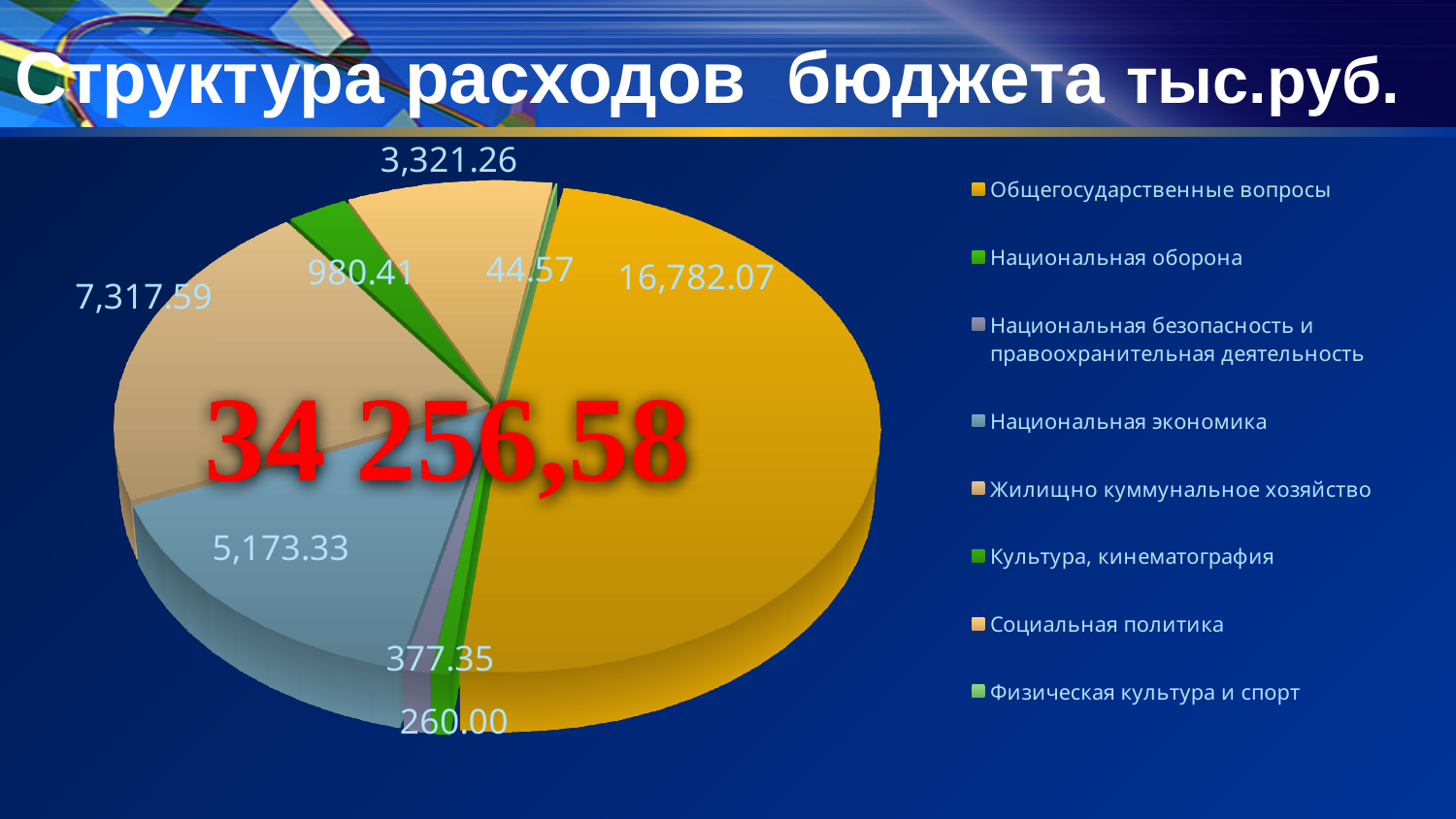
What is the value of the largest slice of the pie chart? 16,782.07 What is the difference between the slices labelled 16,782.07 and 7,317.59? 9,464.48 Which category has the smallest slice of the pie chart? Физическая культура и спорт What is the value of the smallest slice of the pie chart? 44.57 Which is larger in the pie chart: the slice labelled 377.35 or the slice labelled 260.00? 377.35 How many categories does the legend of the pie chart list? 8 What is the value for Жилищно куммунальное хозяйство in the pie chart? 7,317.59 What is the value for Национальная экономика in the pie chart? 5,173.33 What is the value for Социальная политика in the pie chart? 3,321.26 Which category has the largest slice of the pie chart? Общегосударственные вопросы What kind of chart is shown on the slide? pie chart What is the total value printed in the centre of the pie chart? 34 256,58